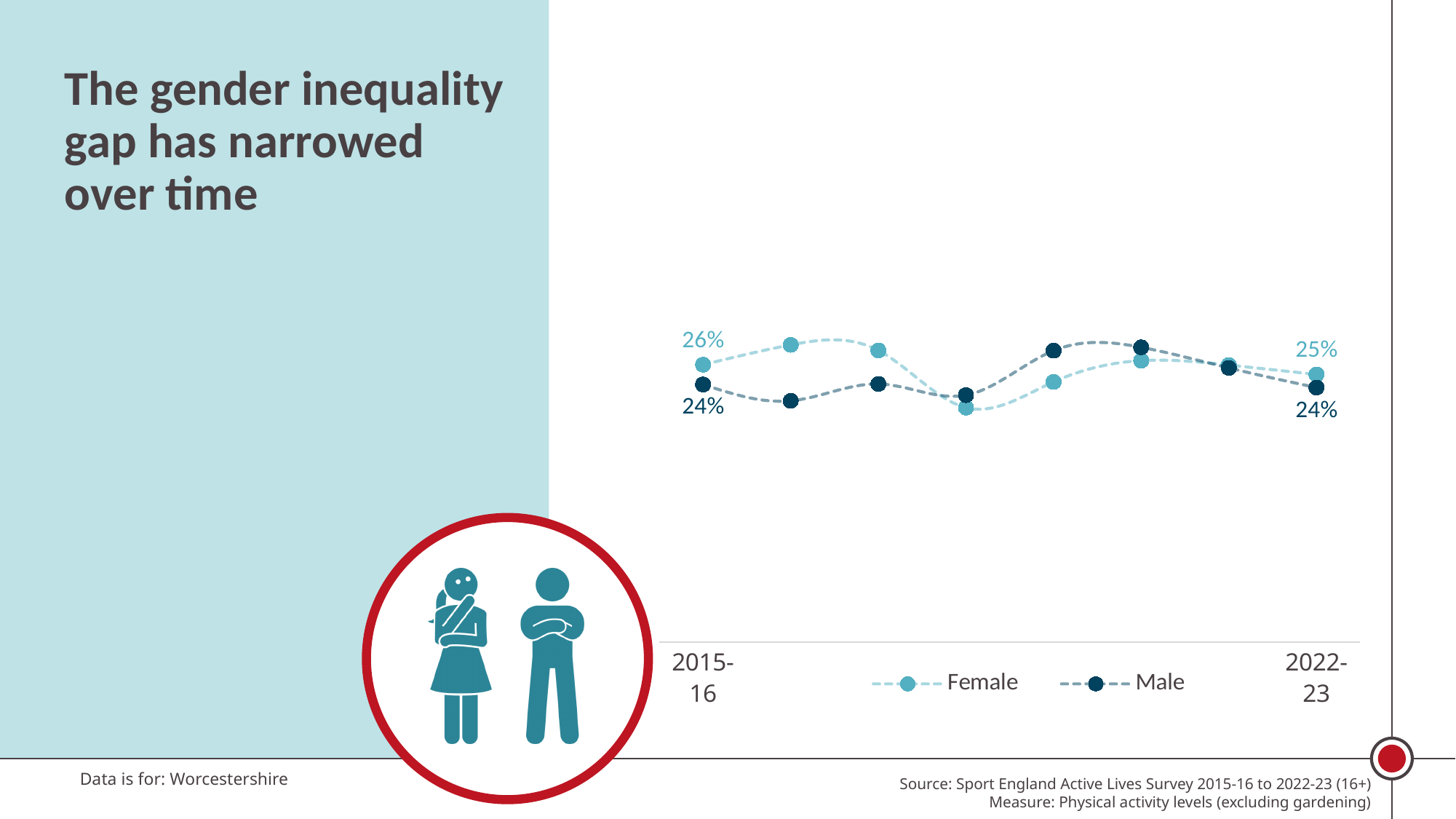
What is the Female value in 2015-16? 26% How many data points does each series have on the chart? 8 What is the Female value in 2022-23? 25% What is the difference between the Female and Male values in 2015-16? 2% What is the Male value in 2022-23? 24% How many series does the chart legend list? 2 What is the Male value in 2015-16? 24% What is the difference between the Female and Male values in 2022-23? 1% Did the Female value rise or fall from 2015-16 to 2022-23? fall What kind of chart is shown on the slide? line chart Which series has the higher value in 2015-16, Female or Male? Female Which series is drawn in the darker colour in the legend? Male